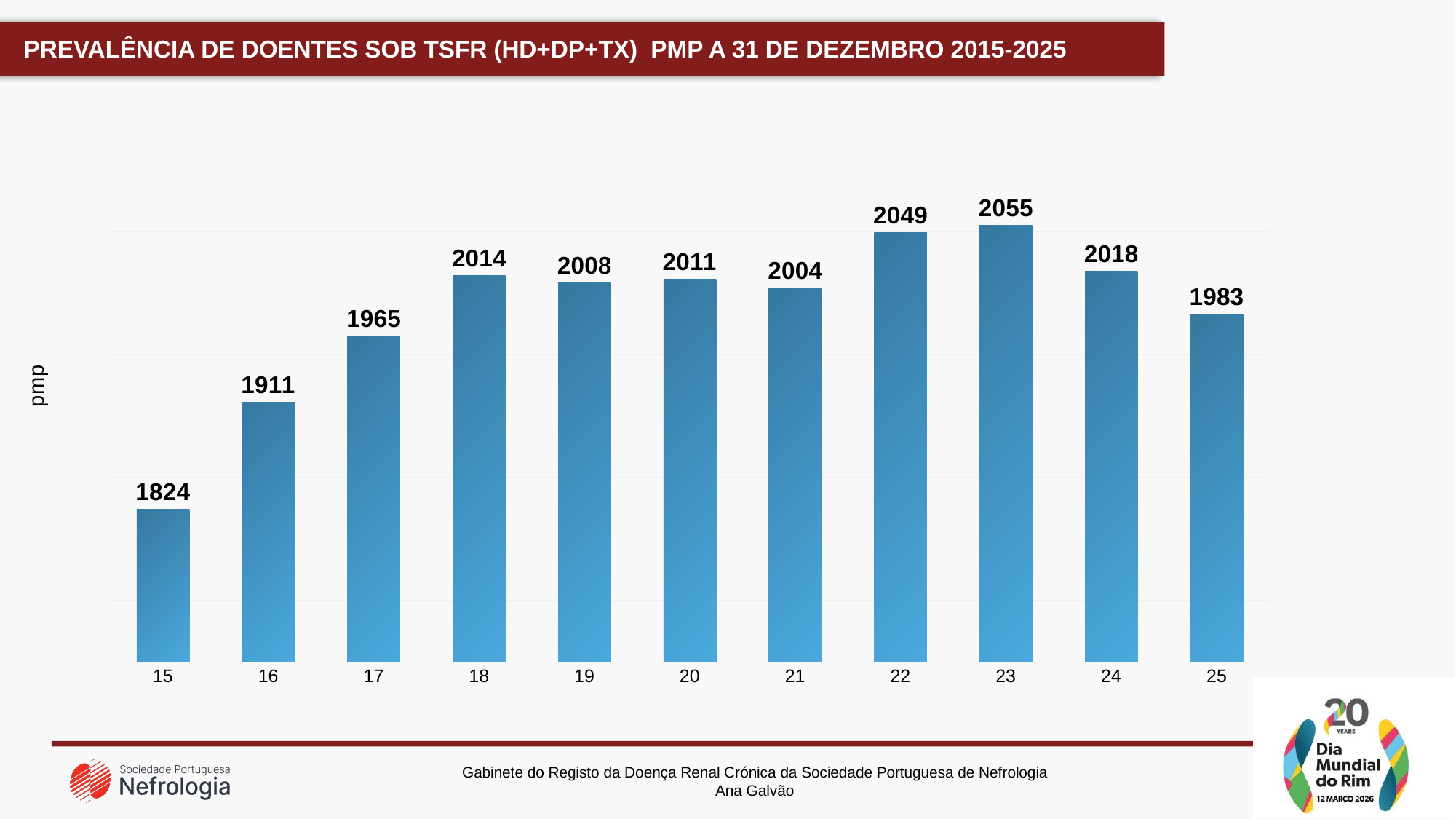
What kind of chart is shown on the slide? bar chart Which year has the highest pmp value? 23 What is the difference between the pmp values for year 24 and year 25? 35 What is the pmp value for year 15? 1824 What is the pmp value for year 25? 1983 How many years (bars) are shown in the chart? 11 What is the label on the vertical axis of the chart? pmp Do the pmp values rise or fall from year 15 to year 18? rise Which year has the lowest pmp value? 15 What is the pmp value for year 23? 2055 Which is larger, the pmp value for year 16 or for year 17? 17 What is the difference between the pmp values for year 23 and year 15? 231